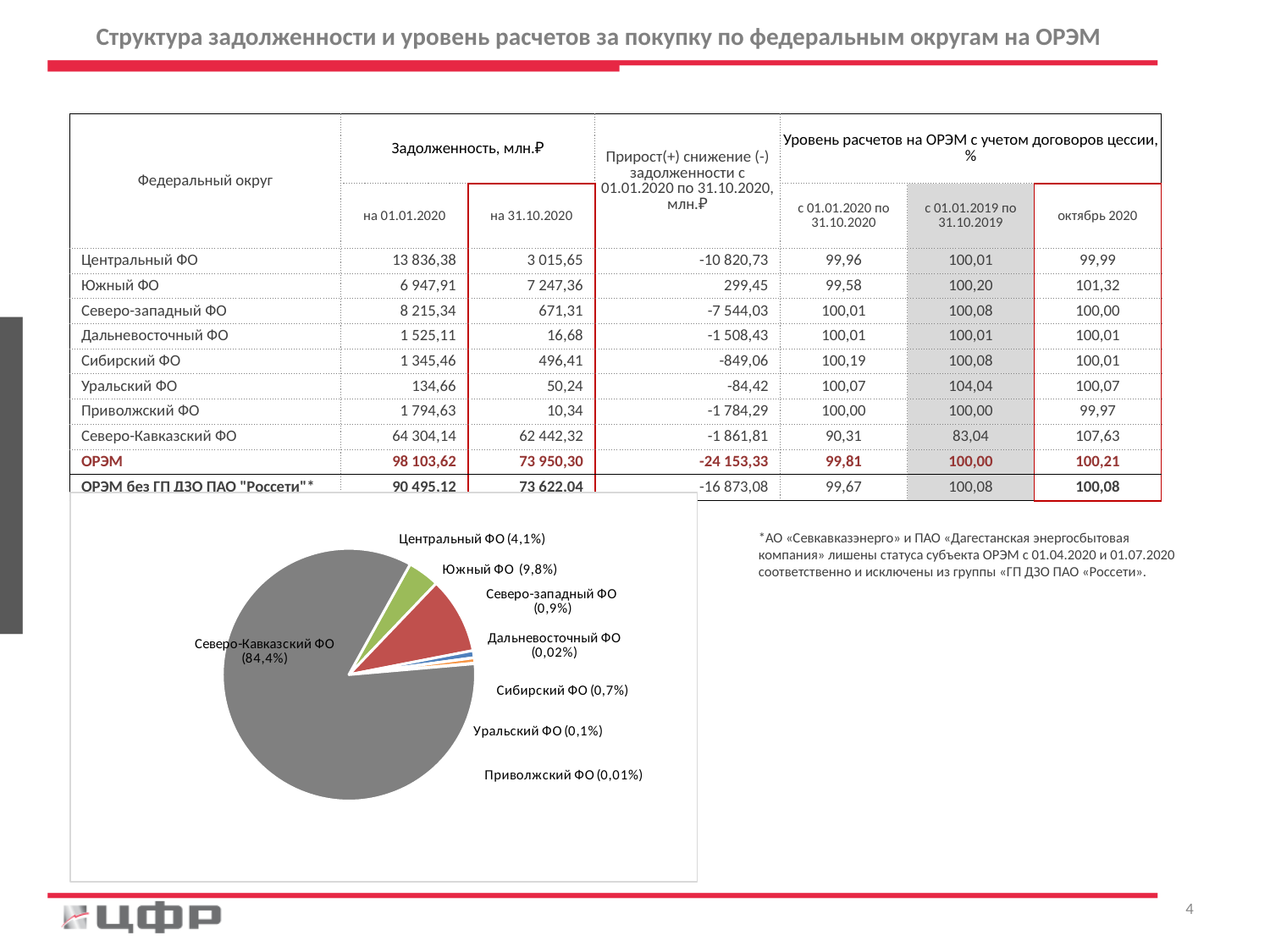
Which slice of the pie chart is the smallest? Приволжский ФО How many slices does the pie chart have? 8 What share of the pie does Дальневосточный ФО hold? 0,02% What share of the pie does Уральский ФО hold? 0,1% What share of the pie does Центральный ФО hold? 4,1% Which slice of the pie chart is the largest? Северо-Кавказский ФО What kind of chart is shown on the slide? pie chart What is the difference in share between Южный ФО and Центральный ФО in the pie chart? 5,7% Which is larger in the pie chart, Южный ФО or Центральный ФО? Южный ФО